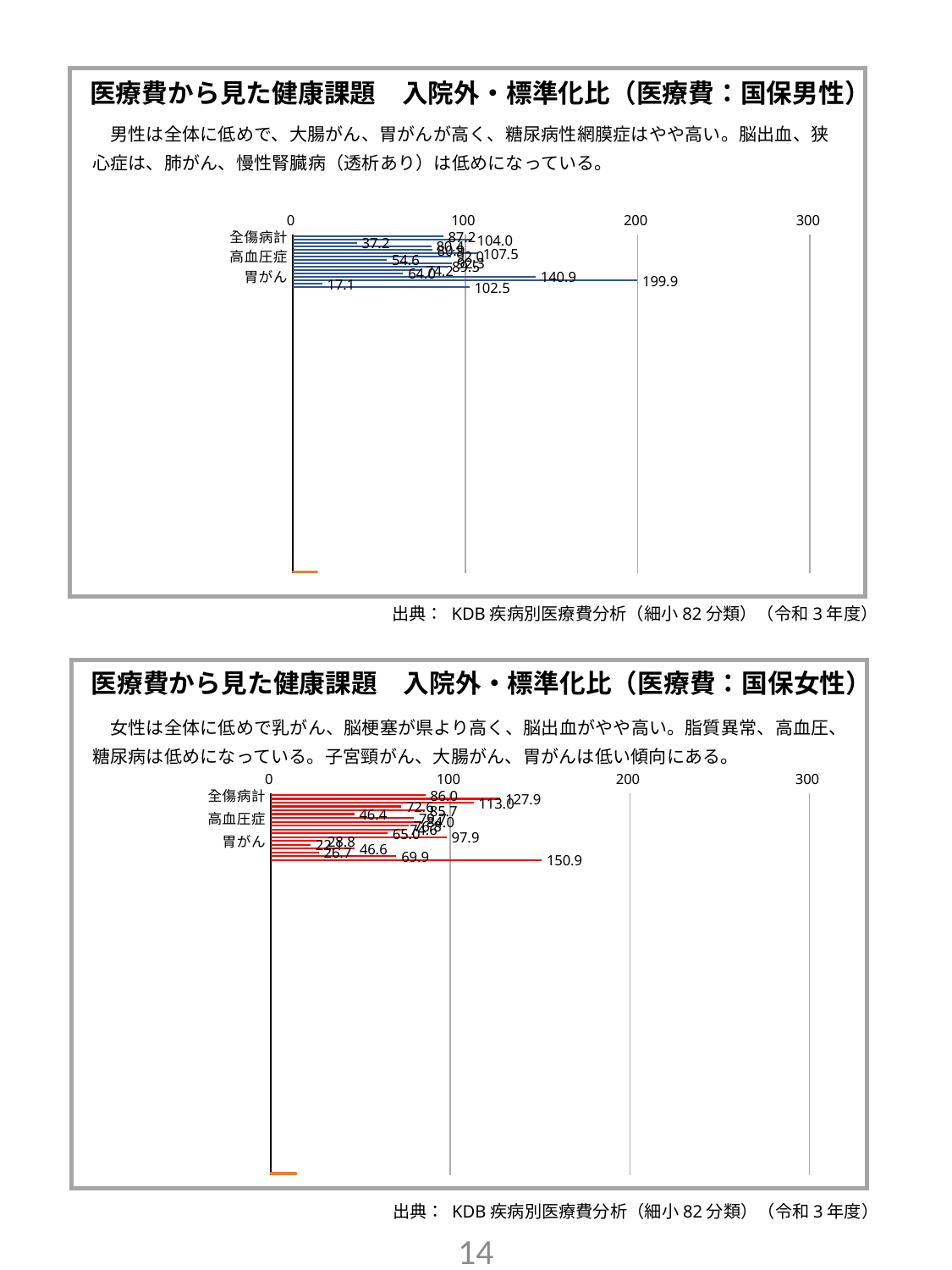
What is the difference between the largest labelled value in the top chart (199.9) and the largest labelled value in the bottom chart (150.9)? 49.0 In the top chart (国保男性), what is the largest value labelled on any bar? 199.9 In the bottom chart (国保女性), is the longest bar greater or less than 100? greater What colour are the bars in the bottom chart (国保女性)? red What kind of chart is the bottom chart (医療費：国保女性)? bar chart What kind of chart is the top chart (医療費：国保男性)? bar chart In the top chart (国保男性), is the longest bar greater or less than 200? less What is the highest tick value shown on the x axis of the top chart (国保男性)? 300 Which chart has the larger maximum labelled value, the top chart (国保男性) or the bottom chart (国保女性)? the top chart (国保男性) In the bottom chart (国保女性), what is the largest value labelled on any bar? 150.9 In the top chart (国保男性), what is the smallest value labelled on any bar? 17.1